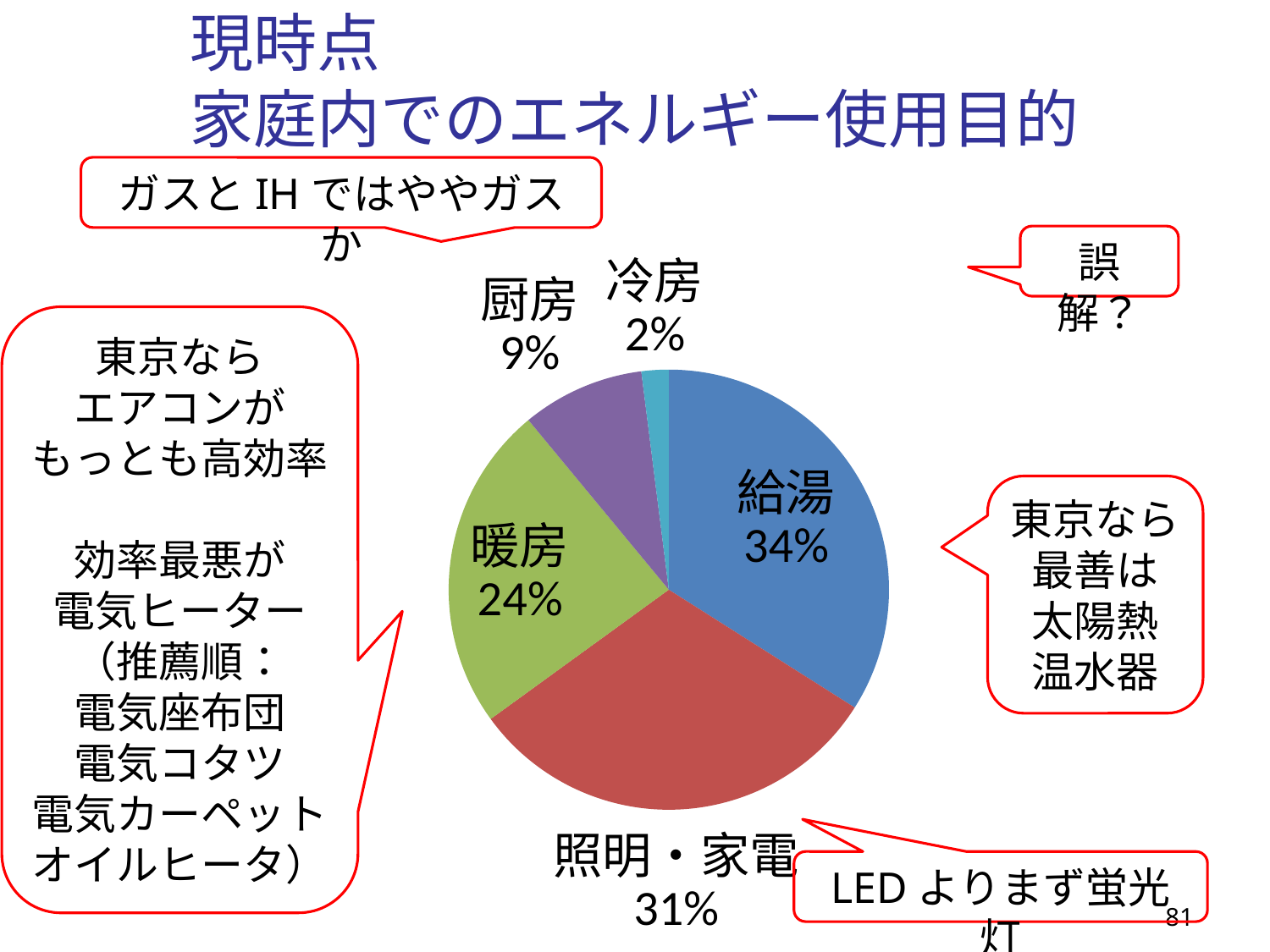
Which category has the smallest share of the pie? 冷房 Which is larger, 照明・家電 or 暖房? 照明・家電 Which category has the largest share of the pie? 給湯 What is the value shown for 暖房? 24% What percentage is shown for 照明・家電? 31% What kind of chart is shown on the slide? pie chart What share of the pie does 給湯 account for? 34% What colour is the 給湯 slice? blue What is the difference in percentage points between 給湯 and 暖房? 10 What is the combined share of 厨房 and 冷房? 11% How many categories are shown in the pie chart? 5 What is the value for 厨房? 9%